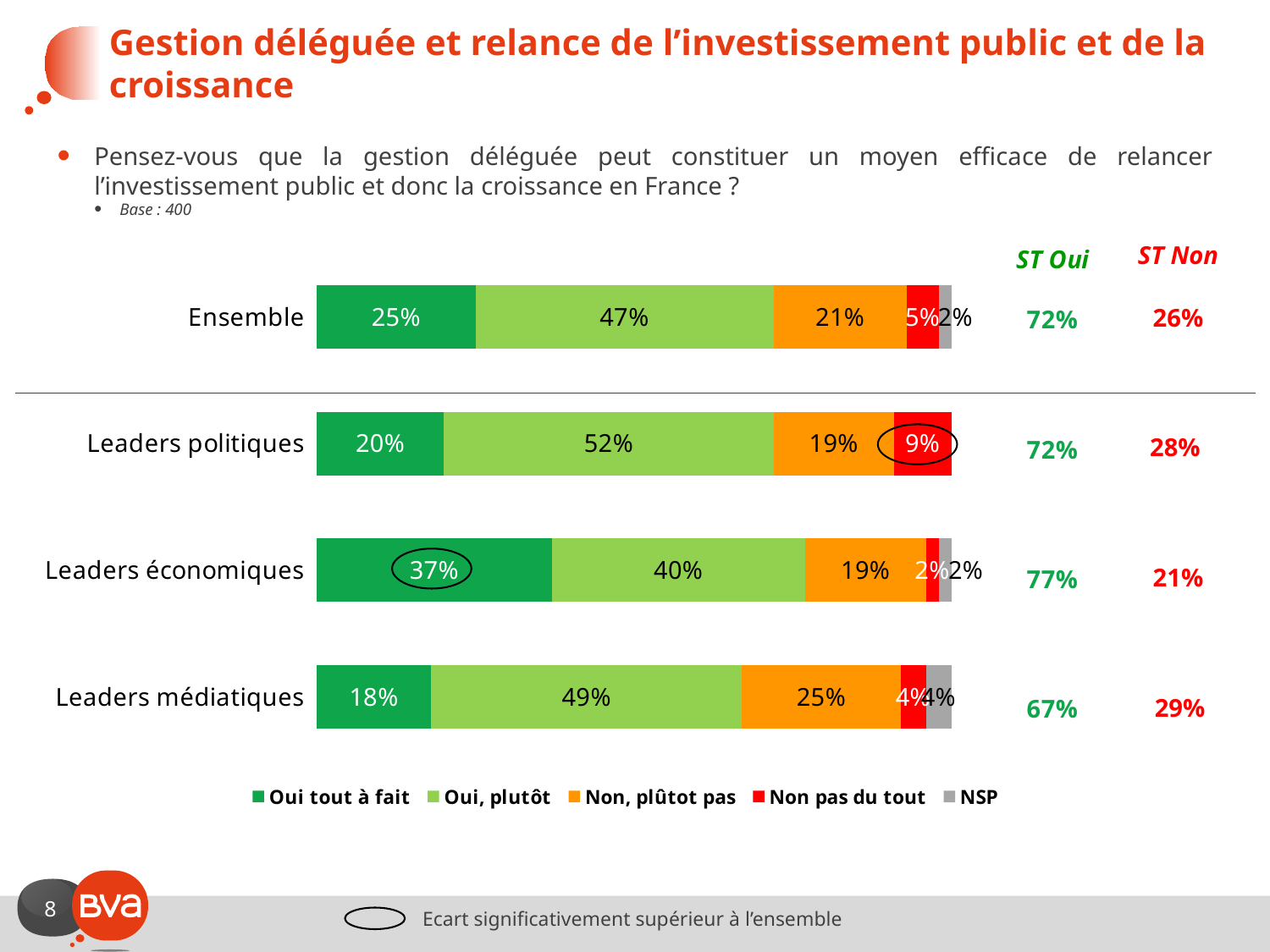
What is the value of "Non pas du tout" for Ensemble? 5% What colour represents the "NSP" series in the legend? Grey Which category has the highest value for "Oui tout à fait"? Leaders économiques How many categories (bars) are plotted in the chart? 4 Which is larger: the "Non pas du tout" value for Leaders politiques or for Leaders médiatiques? Leaders politiques What is the value of "Non, plûtot pas" for Leaders médiatiques? 25% Which category has the lowest value for "Oui tout à fait"? Leaders médiatiques What is the difference between the "Oui, plutôt" values for Leaders politiques and Leaders économiques? 12 percentage points What kind of chart is shown on the slide? Stacked bar chart What is the value of "Oui, plutôt" for Leaders politiques? 52% How many series does the legend list? 5 What is the value of "Oui tout à fait" for Leaders économiques? 37%